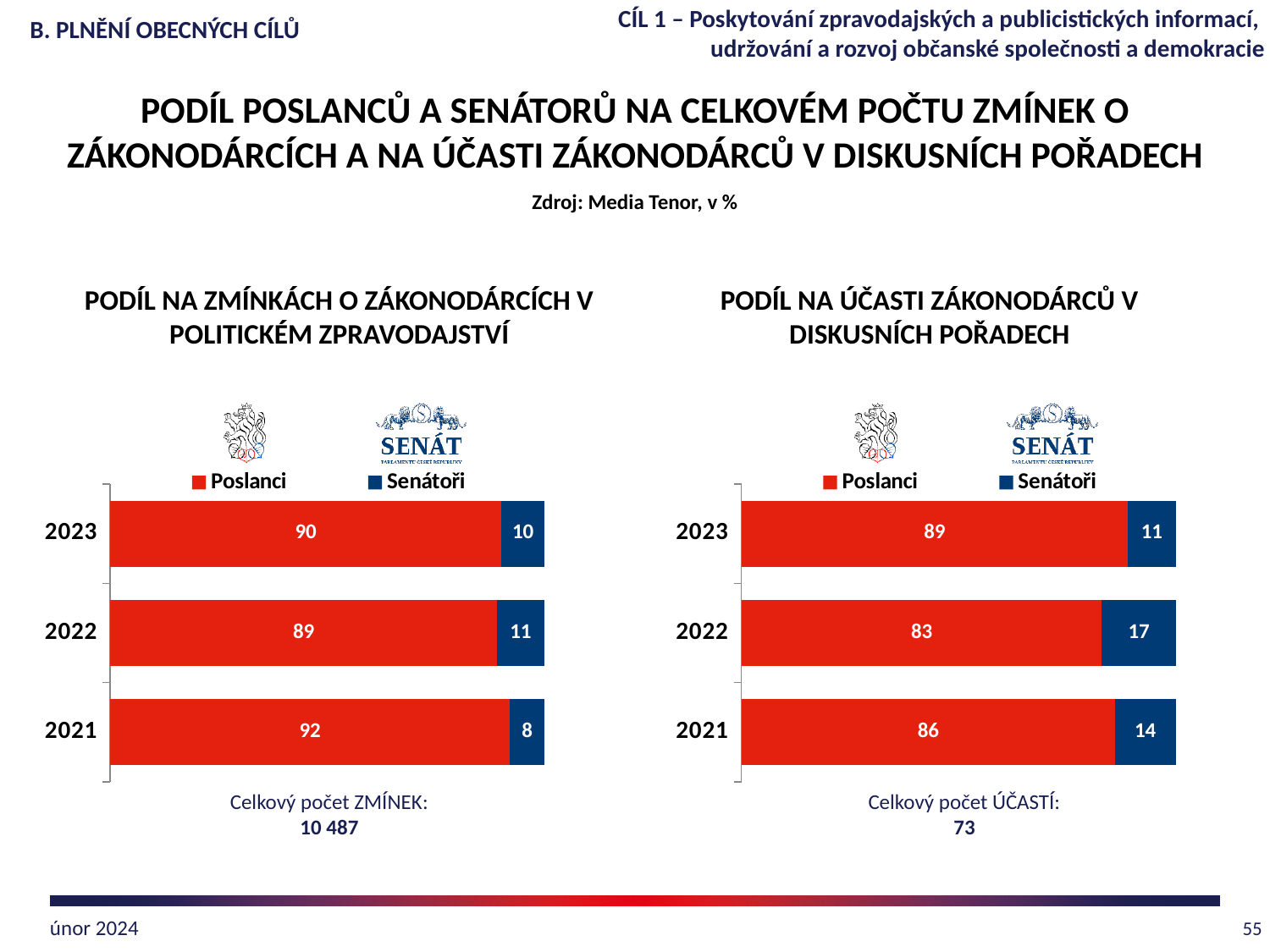
What kind of chart is the right chart (Podíl na účasti zákonodárců v diskusních pořadech)? Stacked bar chart How many years are shown in the right chart (Podíl na účasti zákonodárců v diskusních pořadech)? 3 In the left chart (Podíl na zmínkách o zákonodárcích v politickém zpravodajství), what is the value for Senátoři in 2021? 8 In the right chart (Podíl na účasti zákonodárců v diskusních pořadech), what is the total of the stacked bar for 2022? 100 In the right chart (Podíl na účasti zákonodárců v diskusních pořadech), what is the difference between the Poslanci values for 2023 and 2022? 6 In the left chart (Podíl na zmínkách o zákonodárcích v politickém zpravodajství), what is the value for Poslanci in 2023? 90 In the right chart (Podíl na účasti zákonodárců v diskusních pořadech), what is the value for Senátoři in 2022? 17 In the left chart (Podíl na zmínkách o zákonodárcích v politickém zpravodajství), which year has the highest value for Poslanci? 2021 In the right chart (Podíl na účasti zákonodárců v diskusních pořadech), which year has the lowest value for Senátoři? 2023 In the right chart (Podíl na účasti zákonodárců v diskusních pořadech), what is the value for Poslanci in 2021? 86 In the left chart (Podíl na zmínkách o zákonodárcích v politickém zpravodajství), is the Senátoři value larger in 2022 or in 2021? 2022 How many series does the legend of the left chart (Podíl na zmínkách o zákonodárcích v politickém zpravodajství) list? 2